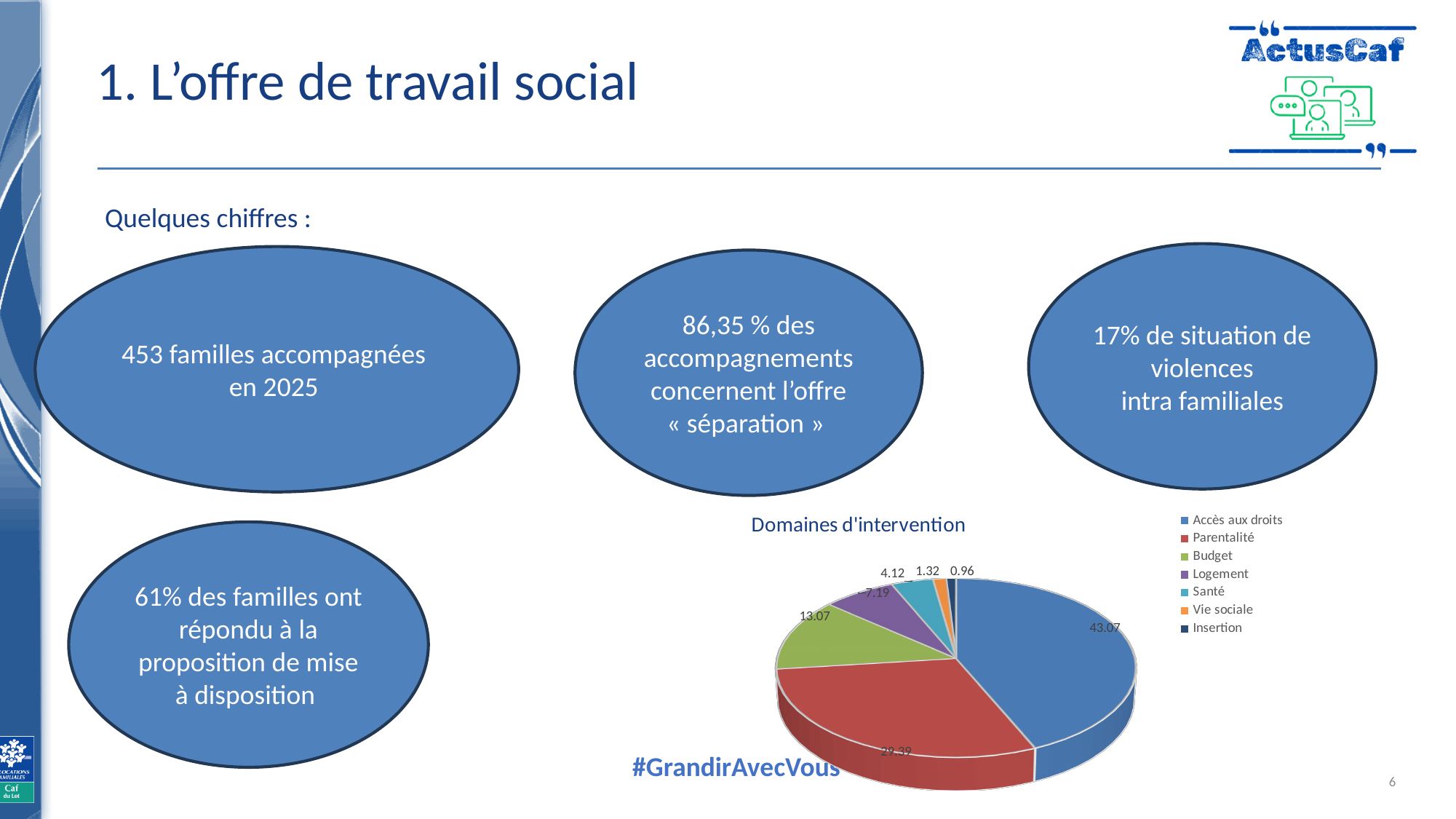
How many categories does the legend of the Domaines d'intervention pie chart list? 7 What is the value shown for Santé in the Domaines d'intervention pie chart? 4.12 In the Domaines d'intervention pie chart, which is larger: Budget or Logement? Budget What is the value shown for Budget in the Domaines d'intervention pie chart? 13.07 What is the value shown for Accès aux droits in the Domaines d'intervention pie chart? 43.07 What is the value shown for Insertion in the Domaines d'intervention pie chart? 0.96 What is the difference between the values for Budget and Logement in the Domaines d'intervention pie chart? 5.88 What type of chart is shown under the title "Domaines d'intervention"? pie chart Which category has the largest slice in the Domaines d'intervention pie chart? Accès aux droits What is the value shown for Logement in the Domaines d'intervention pie chart? 7.19 Which category has the smallest slice in the Domaines d'intervention pie chart? Insertion What colour is the Parentalité slice in the Domaines d'intervention pie chart? red